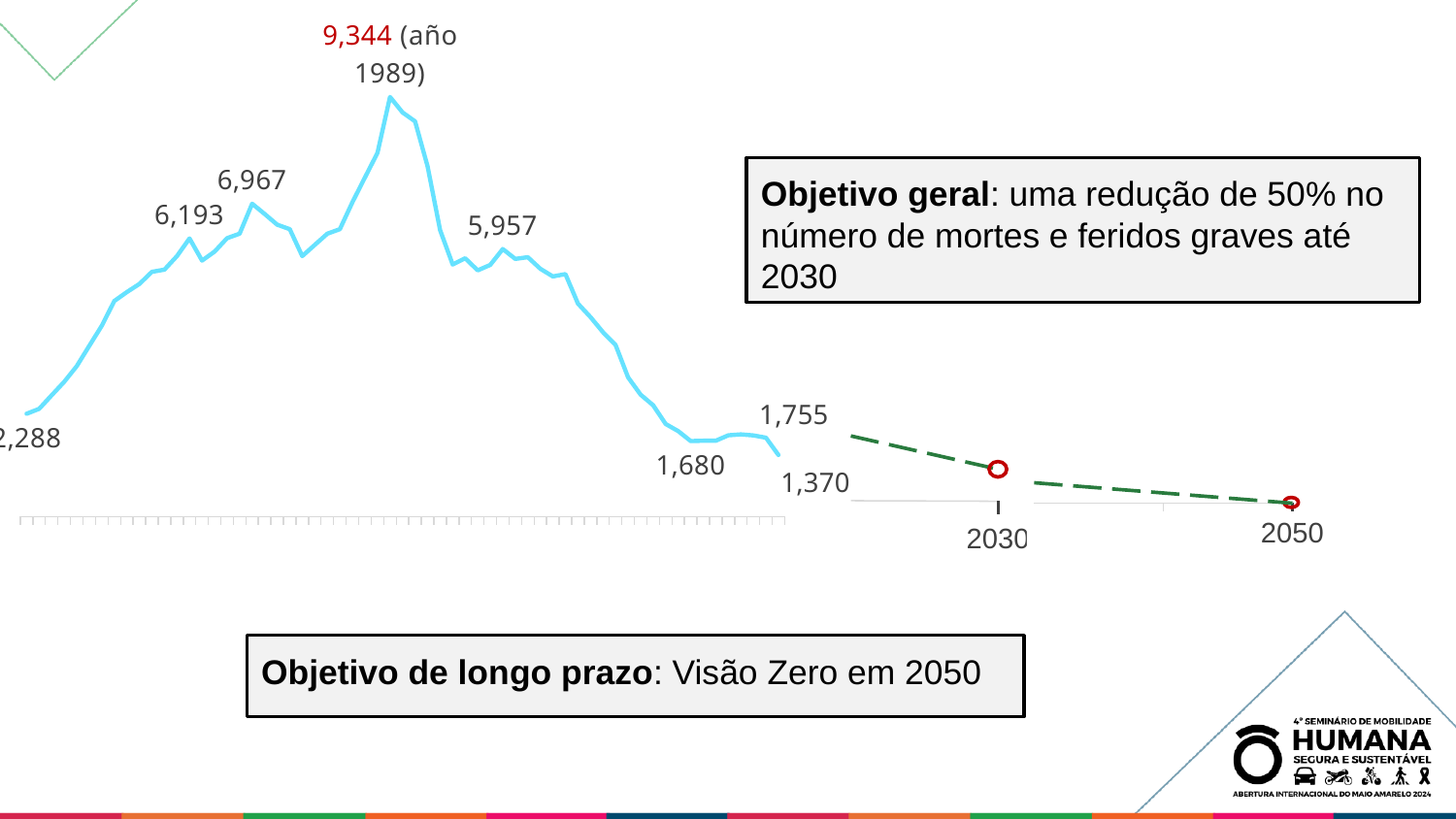
What is the highest value labelled on the line chart? 9,344 What kind of chart is shown on the slide? line chart What is the lowest value labelled on the chart? 1,370 What colour is the dashed projection line extending to 2050? green In which year did the line chart reach its peak of 9,344? 1989 What is the difference between the labelled values 6,967 and 6,193? 774 After the peak of 9,344 in 1989, do the values on the line chart rise or fall? fall What percentage reduction in deaths and serious injuries by 2030 does the 'Objetivo geral' box state? 50% Which two years are marked on the axis of the dashed projection line? 2030 and 2050 Which labelled value is larger, 1,755 or 1,680? 1,755 What is the difference between the peak value 9,344 and the later labelled value 5,957? 3,387 What is the difference between the labelled values 1,755 and 1,370? 385